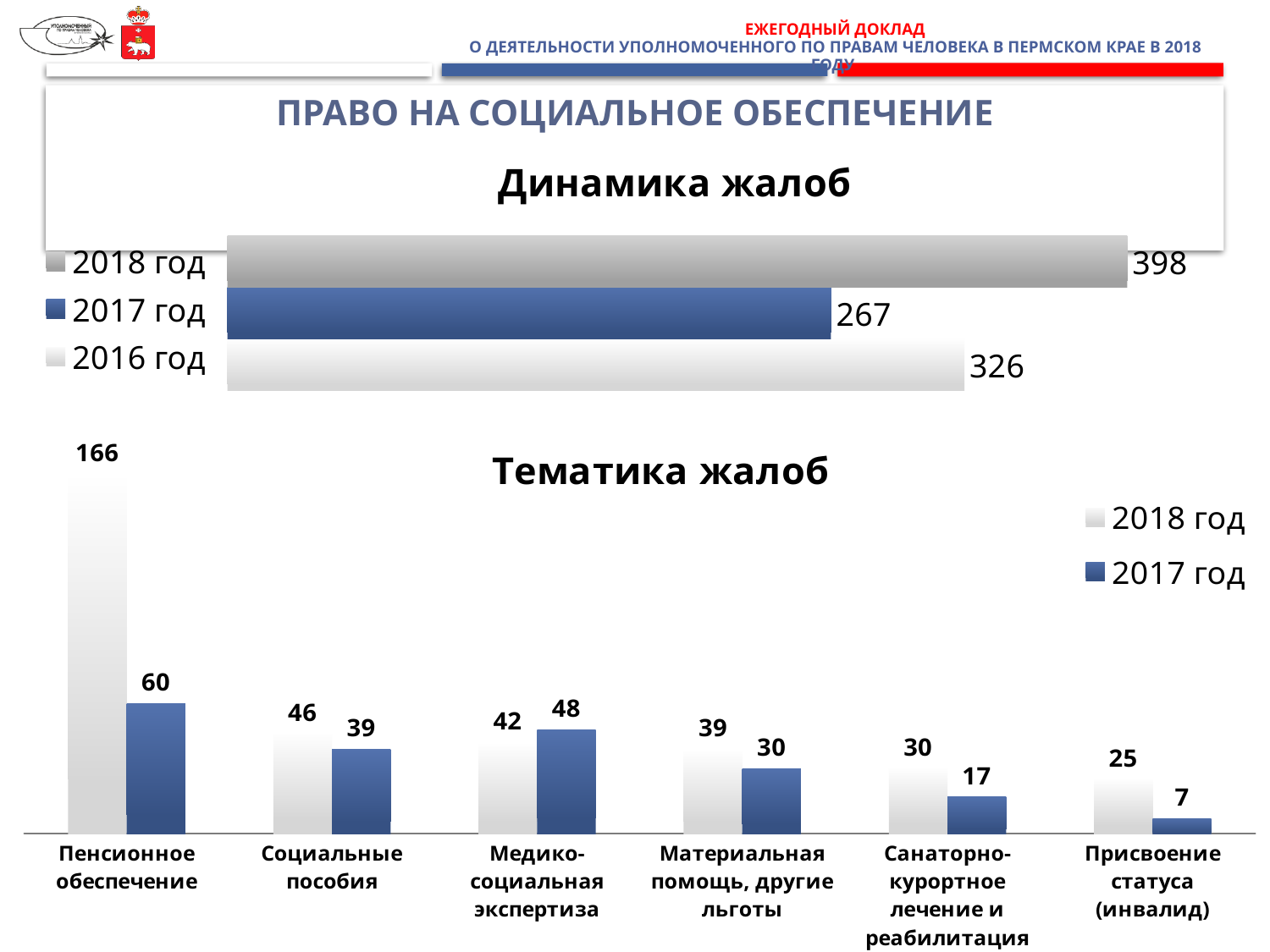
In the 'Тематика жалоб' chart, what is the 2017 год value for Санаторно-курортное лечение и реабилитация? 17 In the 'Динамика жалоб' chart, what is the value for 2018 год? 398 In the 'Тематика жалоб' chart, which is larger for Медико-социальная экспертиза: the 2018 год value or the 2017 год value? 2017 год In the 'Динамика жалоб' chart, which year has the lowest value? 2017 год In the 'Тематика жалоб' chart, how many categories are shown on the x axis? 6 In the 'Динамика жалоб' chart, what is the difference between the 2018 год and 2017 год values? 131 In the 'Тематика жалоб' chart, what is the 2018 год value for Пенсионное обеспечение? 166 In the 'Тематика жалоб' chart, what is the difference between the 2018 год and 2017 год values for Пенсионное обеспечение? 106 What kind of chart is 'Динамика жалоб'? bar chart In the 'Тематика жалоб' chart, which category has the lowest 2017 год value? Присвоение статуса (инвалид) In the 'Тематика жалоб' chart, how many series does the legend list? 2 In the 'Динамика жалоб' chart, how many bars are plotted? 3